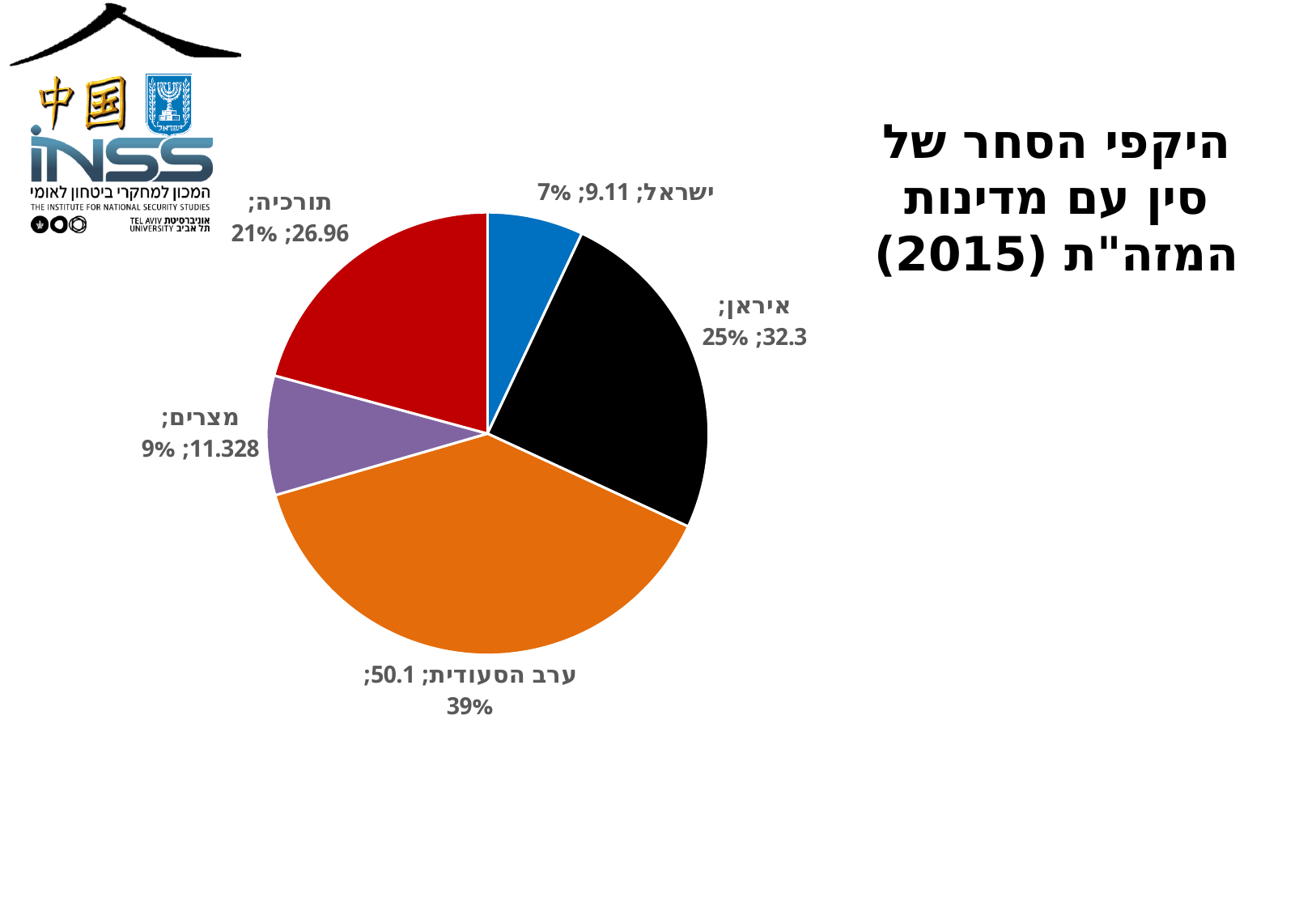
What is the difference between the values for ערב הסעודית (Saudi Arabia) and איראן (Iran)? 17.8 What is the value shown for מצרים (Egypt)? 11.328 What is the value shown for ערב הסעודית (Saudi Arabia)? 50.1 What is the value shown for ישראל (Israel)? 9.11 What percentage share of the pie does ערב הסעודית (Saudi Arabia) have? 39% Which country has the largest slice of the pie? ערב הסעודית (Saudi Arabia) What percentage share of the pie does תורכיה (Turkey) have? 21% How many slices does the pie chart have? 5 What kind of chart is shown on the slide? Pie chart What is the value shown for איראן (Iran)? 32.3 Which is larger, the value for איראן (Iran) or the value for תורכיה (Turkey)? איראן (Iran) Which country has the smallest slice of the pie? ישראל (Israel)